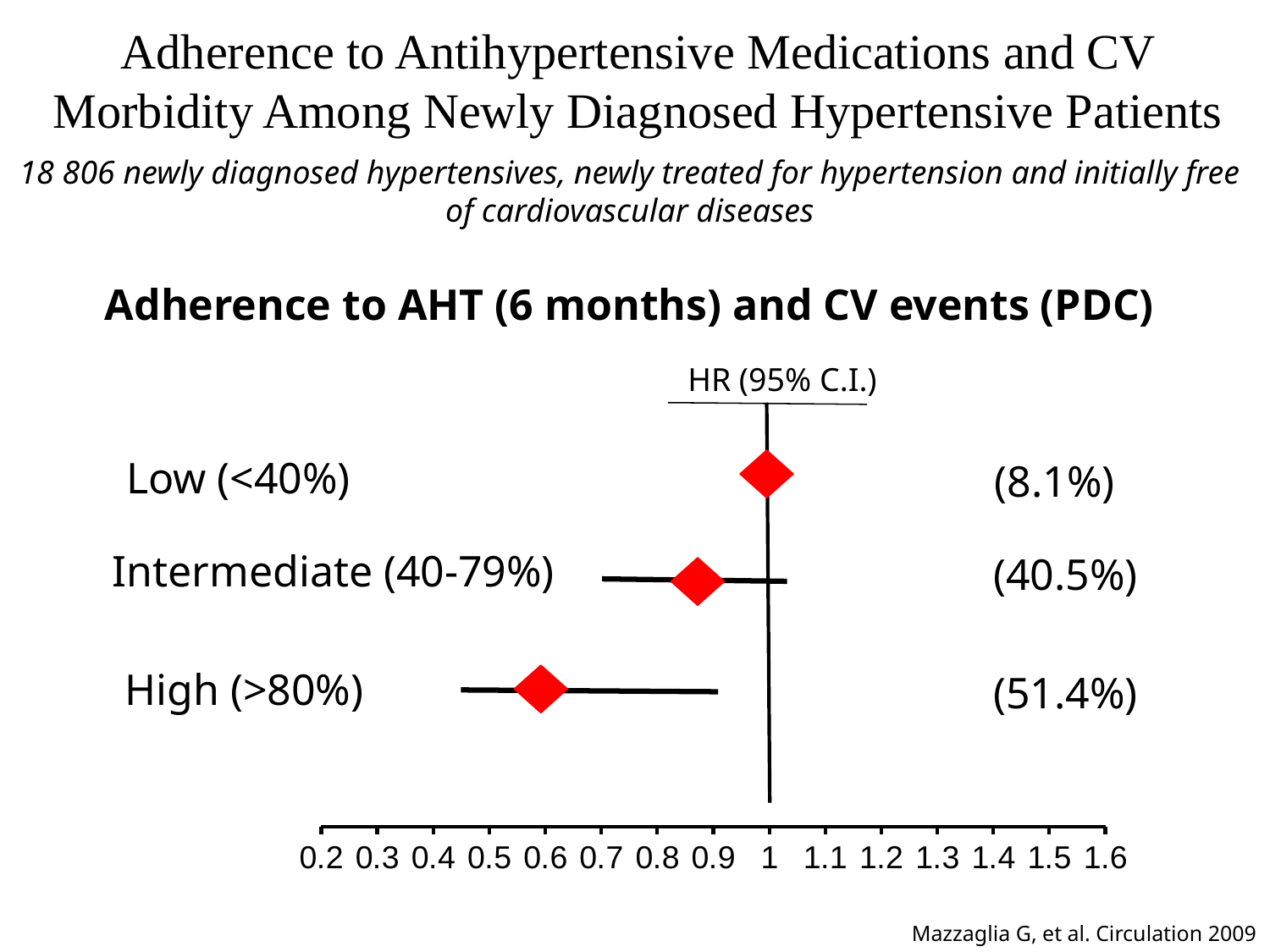
As adherence increases from Low to High, does the hazard ratio rise or fall? fall What quantity does the horizontal axis of the chart represent, according to the label above the plot? HR (95% C.I.) How many adherence categories are plotted in the chart? 3 What percentage is printed next to the High (>80%) adherence category? (51.4%) Which adherence category has the highest hazard ratio in the chart? Low (<40%) What percentage is printed next to the Low (<40%) adherence category? (8.1%) Which adherence category has the lowest hazard ratio in the chart? High (>80%) What is the title of the chart on the slide? Adherence to AHT (6 months) and CV events (PDC) Is the hazard ratio for Intermediate (40-79%) adherence greater or less than 1? less What percentage is printed next to the Intermediate (40-79%) adherence category? (40.5%) Is the hazard ratio for High (>80%) adherence greater or less than 0.7? less Which has the larger hazard ratio, Intermediate (40-79%) or High (>80%) adherence? Intermediate (40-79%)